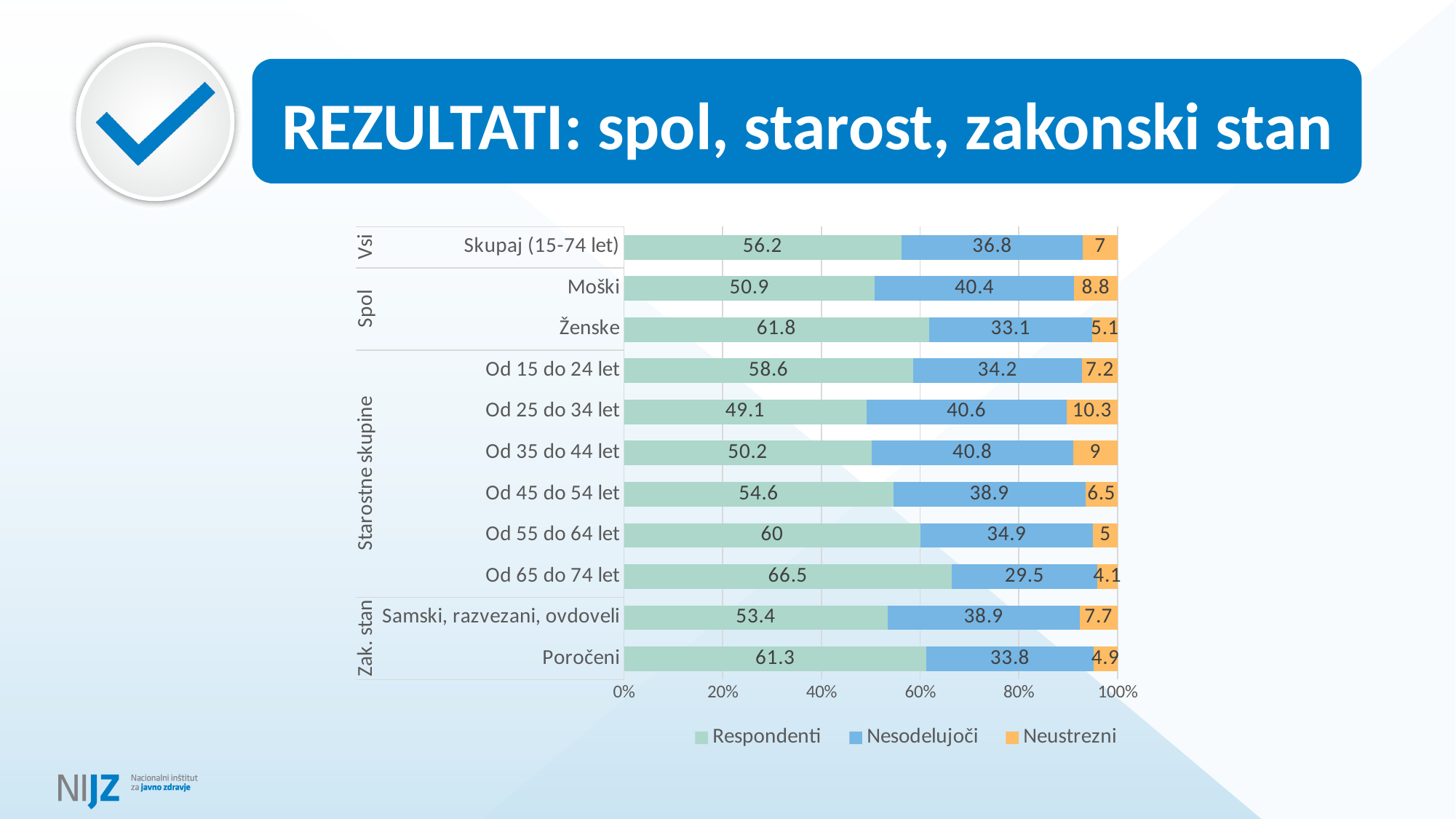
How many series does the legend list? 3 What is the Nesodelujoči value for Od 25 do 34 let? 40.6 What kind of chart is shown on the slide? Stacked bar chart Which category has the lowest Respondenti value? Od 25 do 34 let Which category has the highest Neustrezni value? Od 25 do 34 let What is the Respondenti value for Ženske? 61.8 What is the total of the stacked bar for Skupaj (15-74 let)? 100 Which category has the highest Respondenti value? Od 65 do 74 let What is the difference between the Respondenti values for Ženske and Moški? 10.9 What is the Neustrezni value for Moški? 8.8 How many categories are shown on the chart? 11 Which has a larger Nesodelujoči value, Od 35 do 44 let or Od 65 do 74 let? Od 35 do 44 let